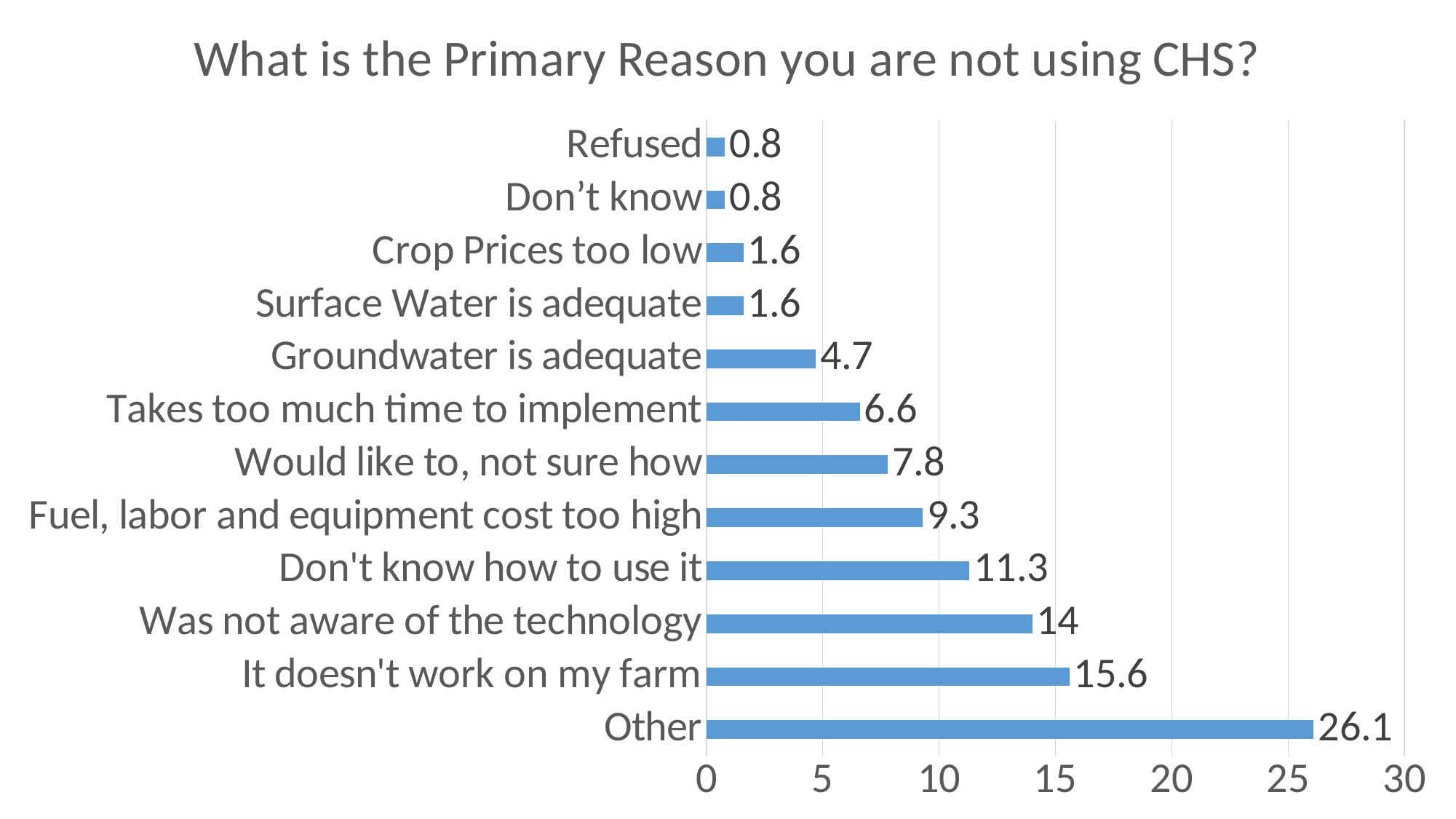
What is the value for "Was not aware of the technology"? 14 What kind of chart is shown on the slide? Bar chart What is the difference between the values for "Other" and "It doesn't work on my farm"? 10.5 What is the maximum value shown on the horizontal axis? 30 What is the difference between the values for "Don't know how to use it" and "Would like to, not sure how"? 3.5 Which is larger, the value for "Takes too much time to implement" or the value for "Groundwater is adequate"? Takes too much time to implement Is the value for "It doesn't work on my farm" greater or less than 10? greater Which category has the highest value? Other What is the title of the chart? What is the Primary Reason you are not using CHS? What is the value for "Fuel, labor and equipment cost too high"? 9.3 What is the value for "Groundwater is adequate"? 4.7 How many categories are shown in the chart? 12